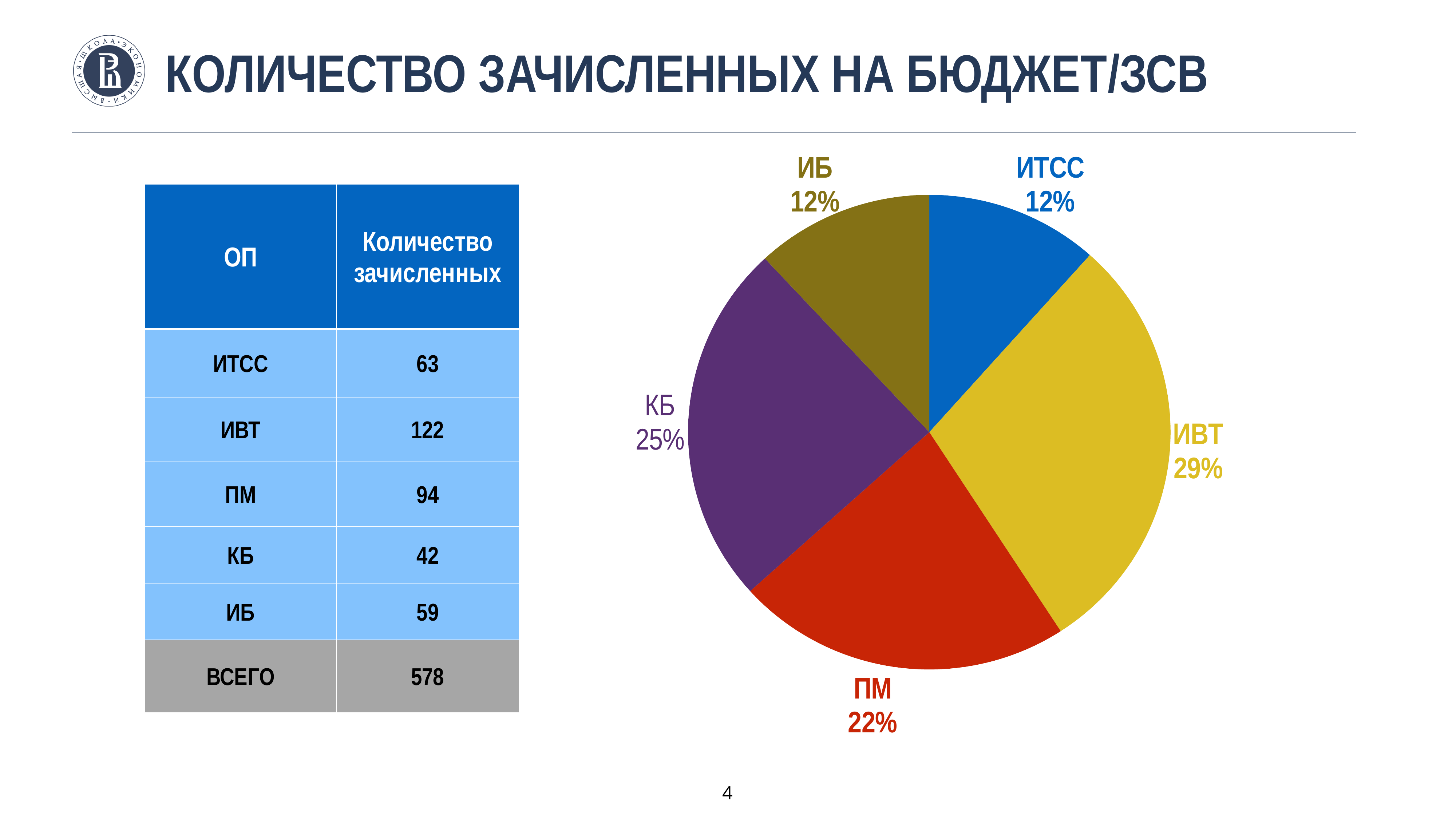
Which slice of the pie chart is the largest? ИВТ By how many percentage points does the ПМ share exceed the ИБ share in the pie chart? 10% What kind of chart is shown on the slide? pie chart What share of the pie chart does ИБ have? 12% How many slices does the pie chart have? 5 What share of the pie chart does ИТСС have? 12% What share of the pie chart does ИВТ have? 29% What share of the pie chart does ПМ have? 22% By how many percentage points does the ИВТ share exceed the КБ share in the pie chart? 4% What share of the pie chart does КБ have? 25% Which slice is larger in the pie chart, КБ or ПМ? КБ What colour is the ИВТ slice in the pie chart? yellow